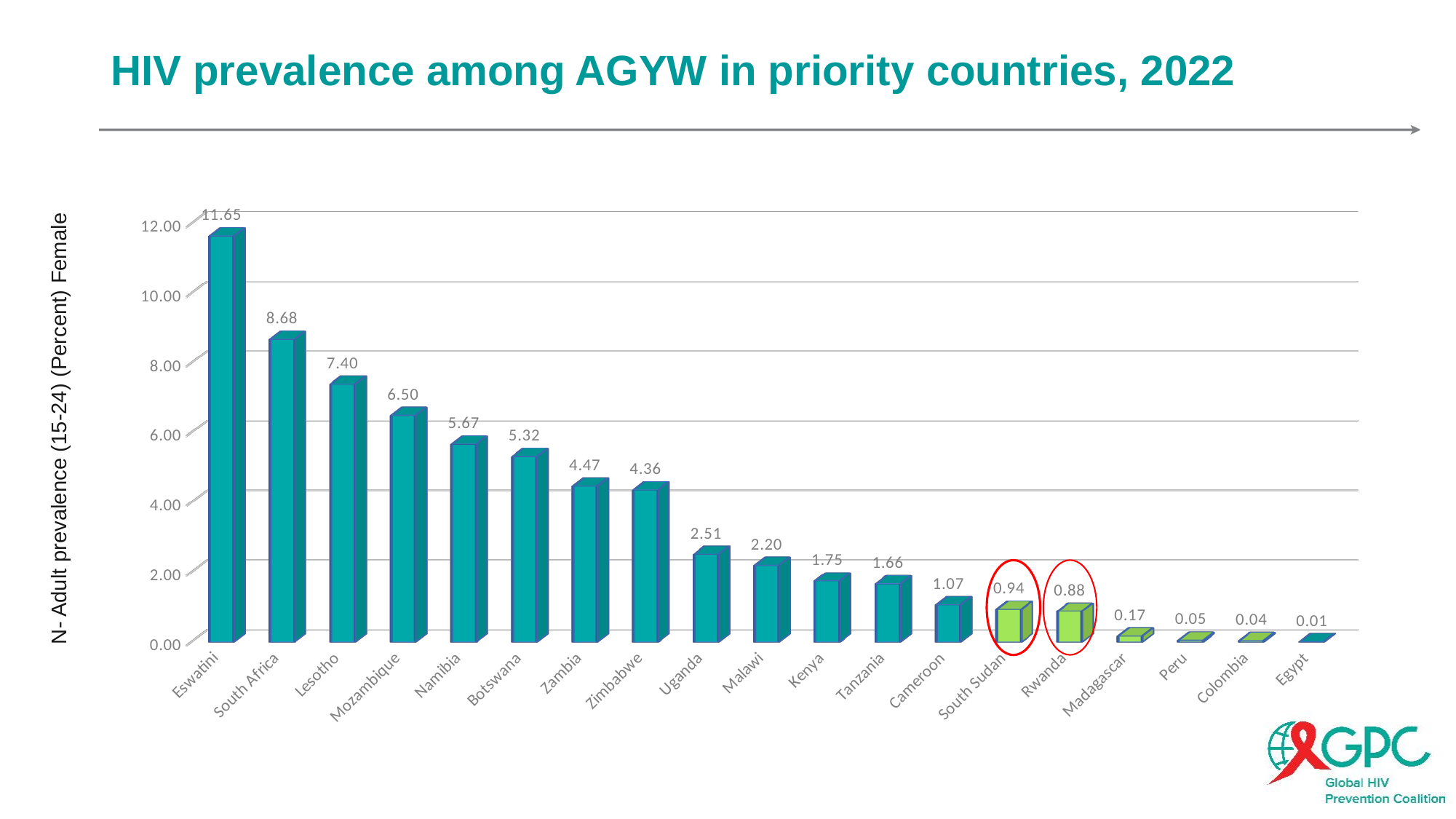
What kind of chart is shown on the slide? Bar chart Which has a higher value, Zambia or Uganda? Zambia Do the values rise or fall from left to right along the x axis? Fall What is the value shown for Mozambique? 6.50 How many countries are shown in the chart? 19 Which country has the highest HIV prevalence in the chart? Eswatini Which two countries' bars are circled in red on the chart? South Sudan and Rwanda Which country has the lowest HIV prevalence in the chart? Egypt What is the difference between the values for South Africa and Lesotho? 1.28 What is the HIV prevalence value shown for Eswatini? 11.65 Is the value for Namibia greater or less than 4.00? greater What is the value shown for Rwanda? 0.88